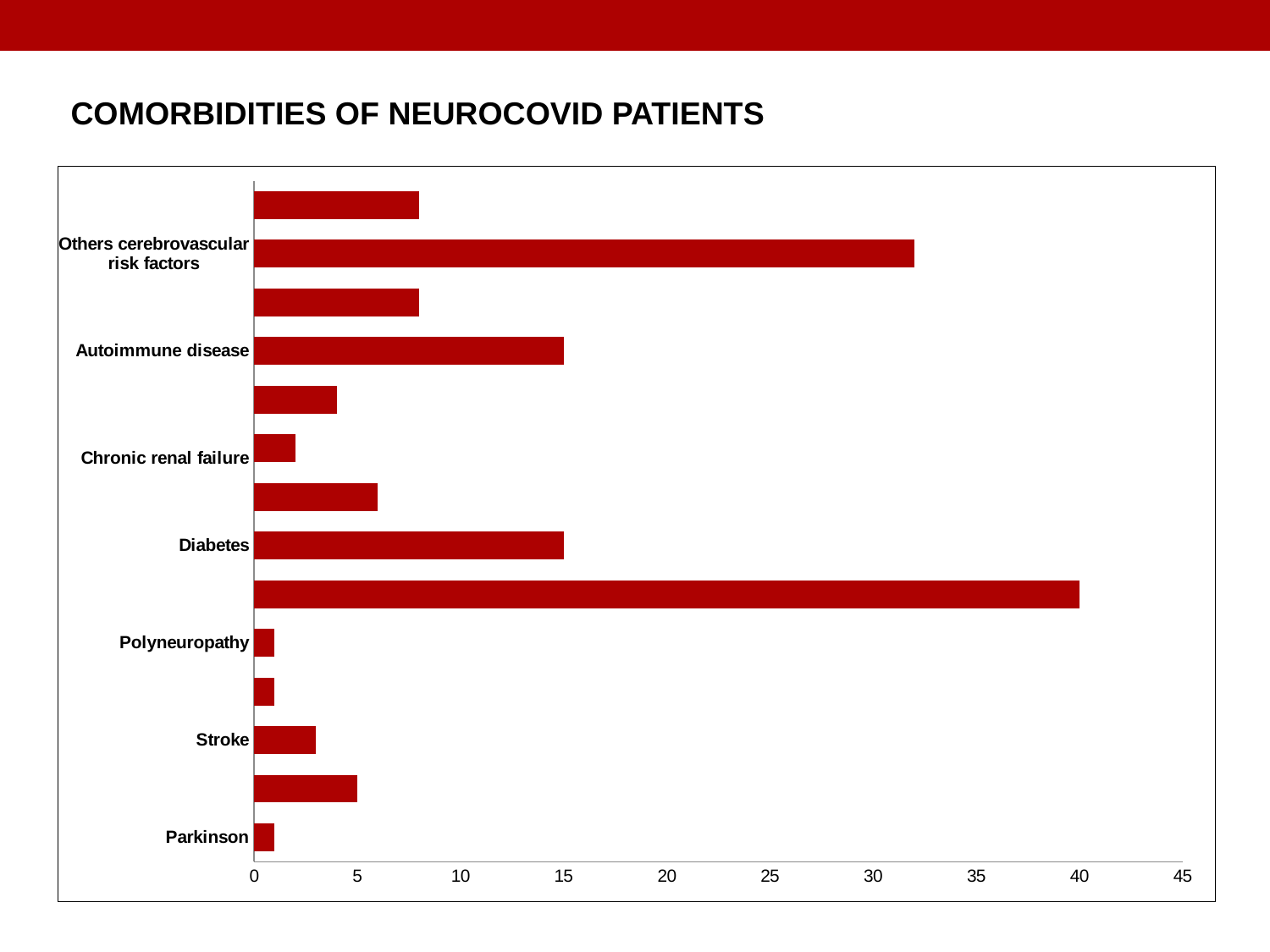
Which is larger, the value for Diabetes or the value for Stroke? Diabetes What is the highest value shown on the horizontal axis? 45 Is the value for Parkinson greater or less than 5? less Is the value for Others cerebrovascular risk factors greater or less than 30? greater Which is larger, the value for Autoimmune disease or the value for Chronic renal failure? Autoimmune disease What is the value for Autoimmune disease? 15 Is the value for Chronic renal failure greater or less than 5? less What is the value for Diabetes? 15 What is the title of the chart? COMORBIDITIES OF NEUROCOVID PATIENTS What kind of chart is shown on the slide? bar chart Which is larger, the value for Others cerebrovascular risk factors or the value for Autoimmune disease? Others cerebrovascular risk factors